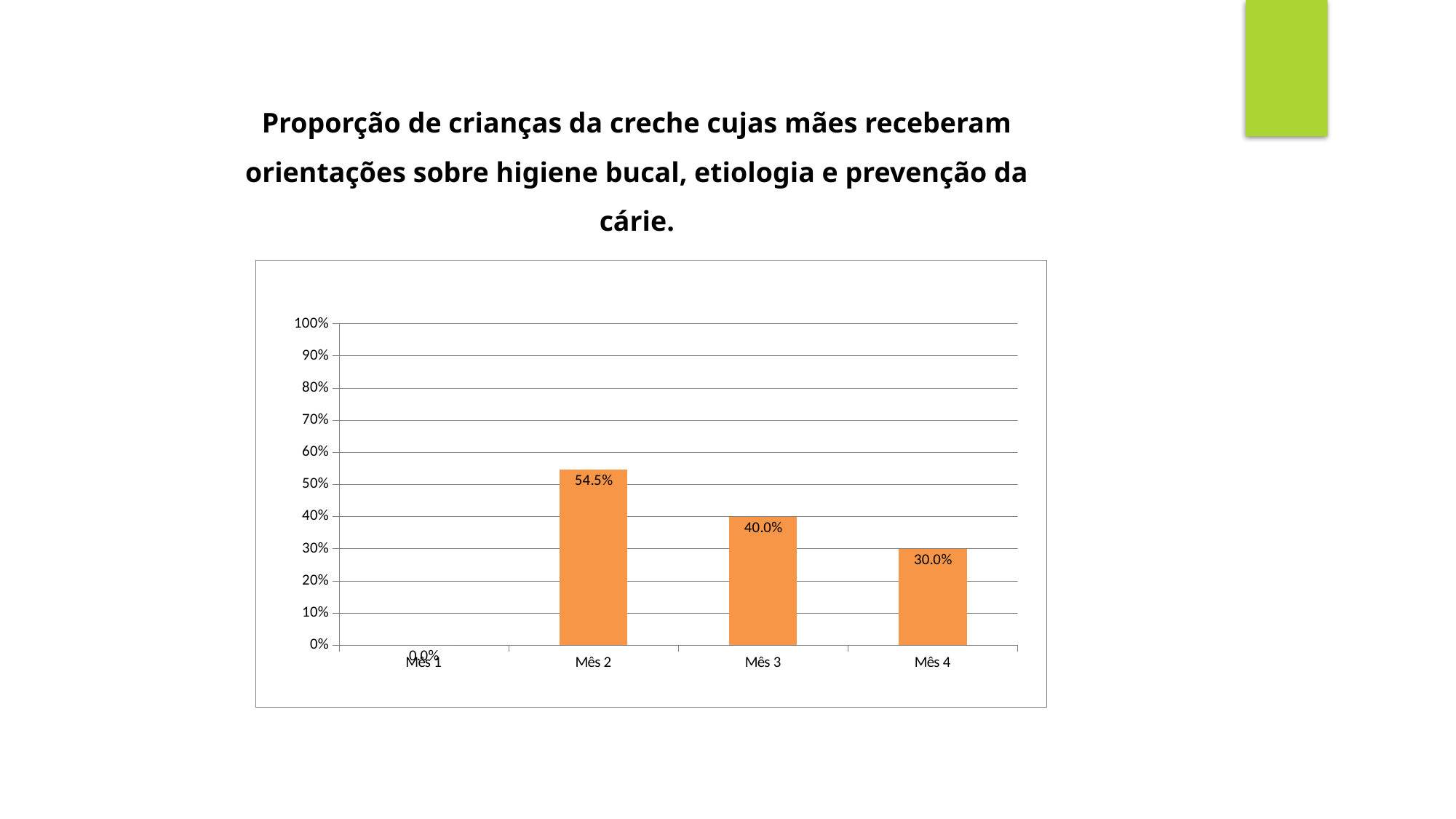
Which month has the lowest value? Mês 1 What is the difference between the values for Mês 2 and Mês 3? 14.5% What is the value for Mês 2? 54.5% What is the value for Mês 4? 30.0% What kind of chart is shown on the slide? Bar chart Do the values rise or fall from Mês 2 to Mês 4? Fall What is the value for Mês 3? 40.0% What is the difference between the values for Mês 3 and Mês 4? 10.0% How many months are shown on the x axis? 4 Which is larger, the value for Mês 3 or the value for Mês 4? Mês 3 What is the value for Mês 1? 0.0% Which month has the highest value? Mês 2